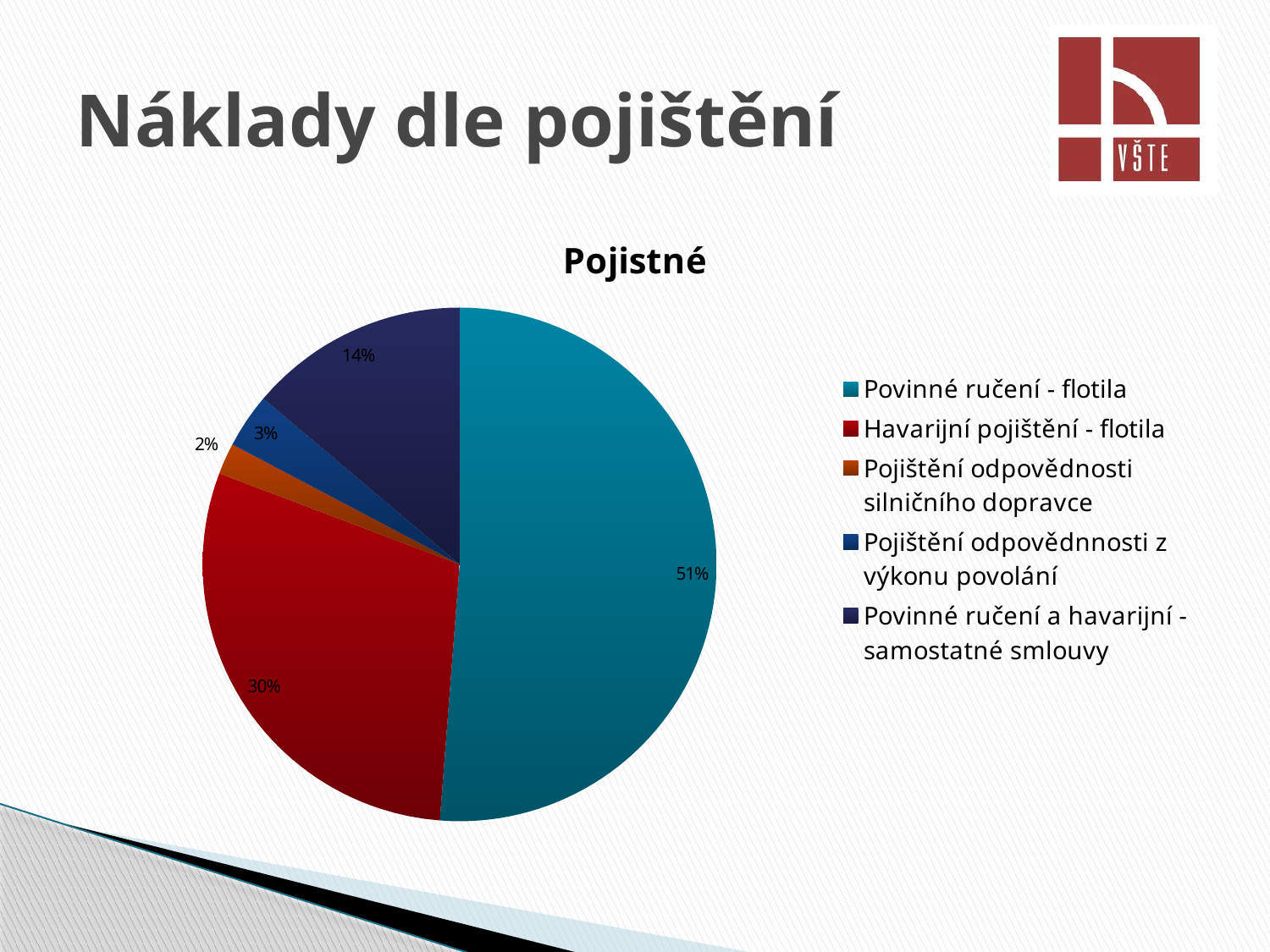
Which category has the largest slice of the pie? Povinné ručení - flotila What is the difference in percentage points between 'Povinné ručení - flotila' and 'Havarijní pojištění - flotila'? 21% What share of the pie does 'Povinné ručení - flotila' have? 51% What share of the pie does 'Povinné ručení a havarijní - samostatné smlouvy' have? 14% What share of the pie does 'Pojištění odpovědnosti silničního dopravce' have? 2% Which category has the smallest slice of the pie? Pojištění odpovědnosti silničního dopravce Which is larger: the slice for 'Povinné ručení a havarijní - samostatné smlouvy' or the slice for 'Pojištění odpovědnnosti z výkonu povolání'? Povinné ručení a havarijní - samostatné smlouvy How many categories does the legend list? 5 What is the title of the chart? Pojistné What type of chart is shown on the slide? pie chart